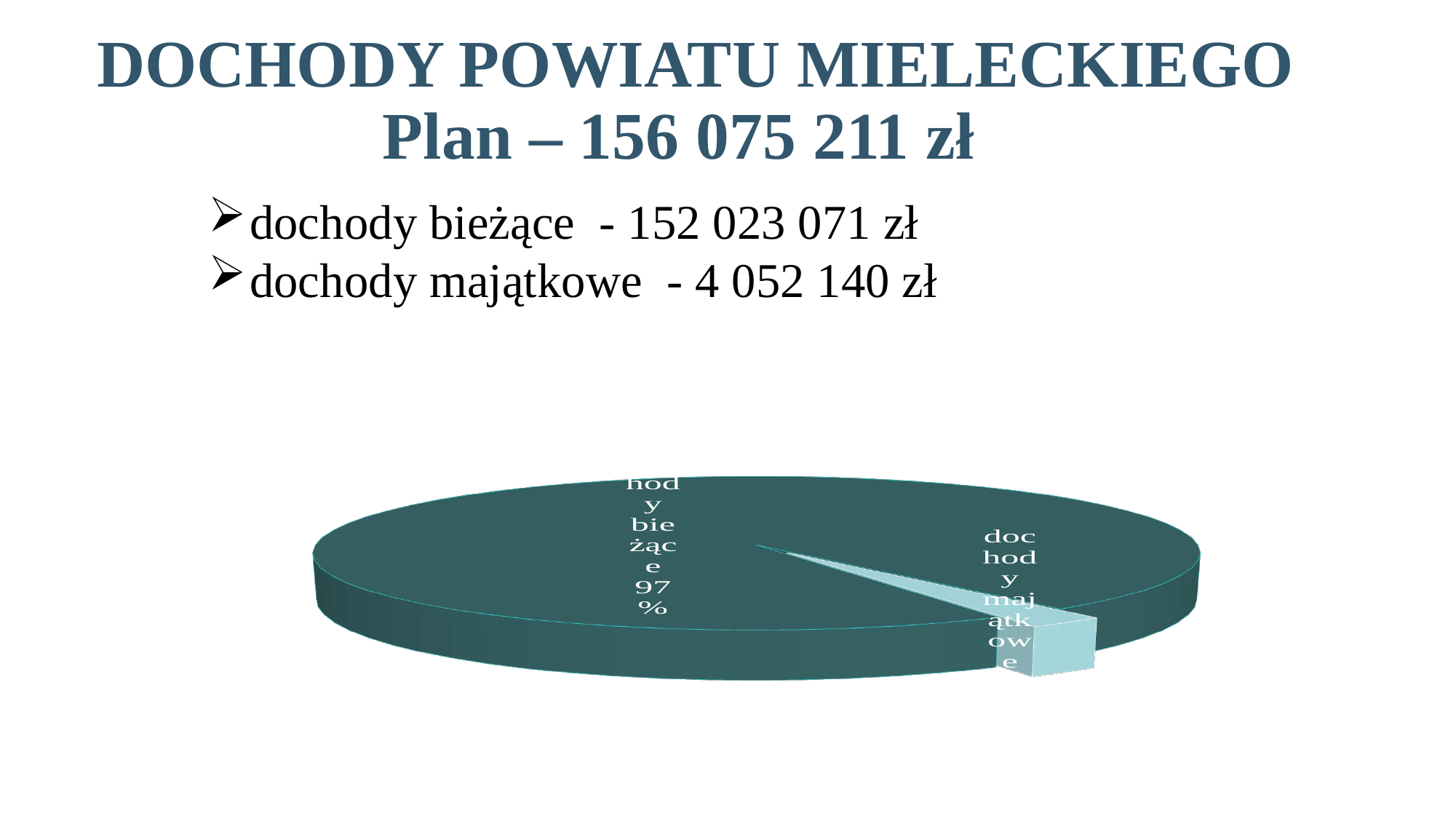
How many slices does the pie chart have? 2 What kind of chart is shown on the slide? pie chart Which slice of the pie chart is the smallest? dochody majątkowe Which slice of the pie chart is pulled out (exploded) from the rest of the pie? dochody majątkowe Which slice of the pie chart is the largest? dochody bieżące Which slice is larger in the pie chart, dochody bieżące or dochody majątkowe? dochody bieżące What share of the pie does the dochody bieżące slice represent? 97% Which slice of the pie chart is drawn in the lighter colour? dochody majątkowe